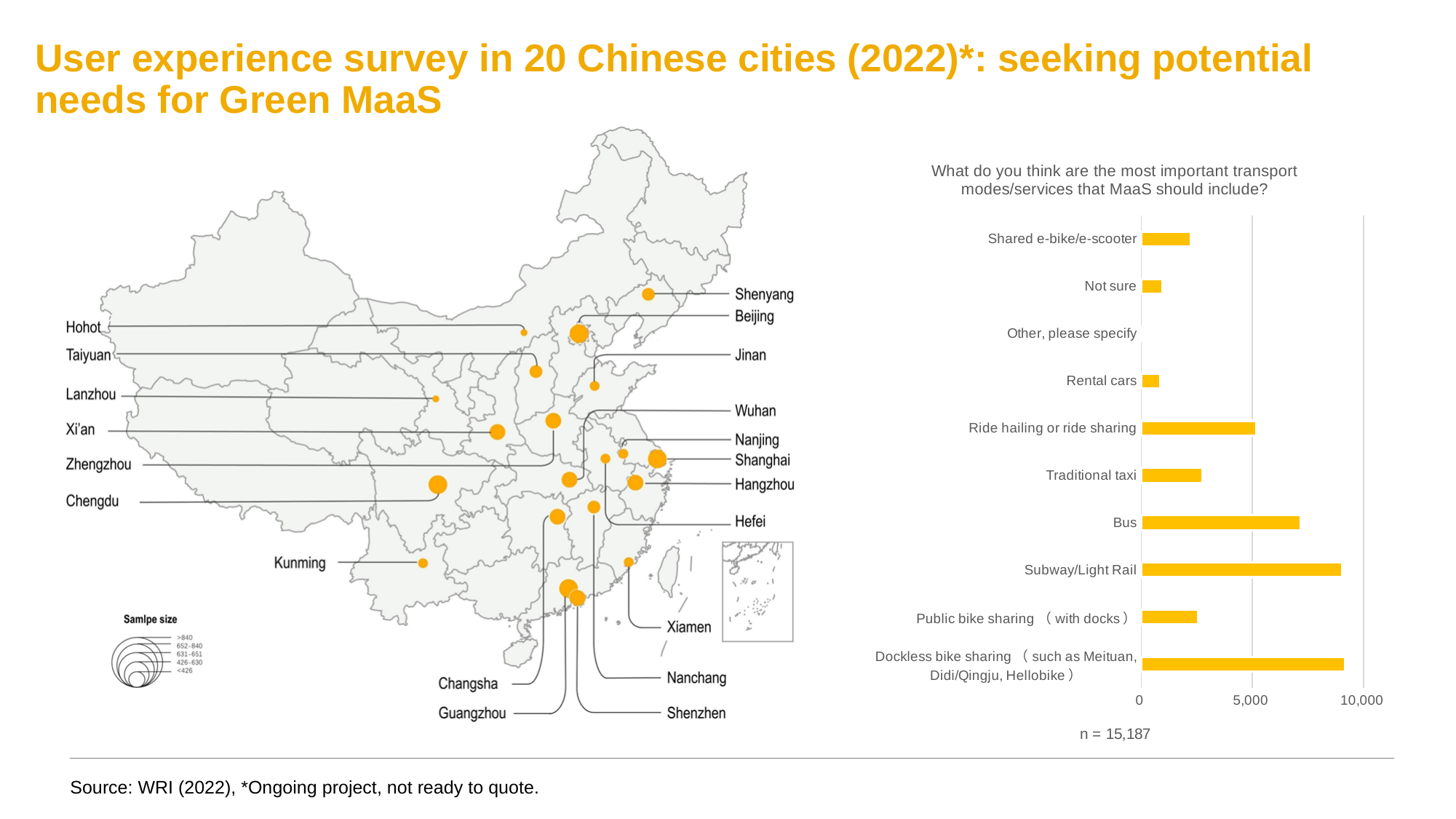
What survey question is shown as the title of the bar chart? What do you think are the most important transport modes/services that MaaS should include? How many transport modes/services are listed as categories in the bar chart? 10 In the bar chart, is the value for Subway/Light Rail greater or less than 5,000? greater In the bar chart, is the value for Bus greater or less than 5,000? greater In the bar chart, is the value for Not sure greater or less than 5,000? less In the bar chart, which category has the lowest value? Other, please specify In the bar chart, which is larger: Shared e-bike/e-scooter or Traditional taxi? Traditional taxi What sample size (n) is stated below the bar chart? n = 15,187 In the bar chart, which is larger: Bus or Ride hailing or ride sharing? Bus What kind of chart is shown on the right side of the slide? bar chart